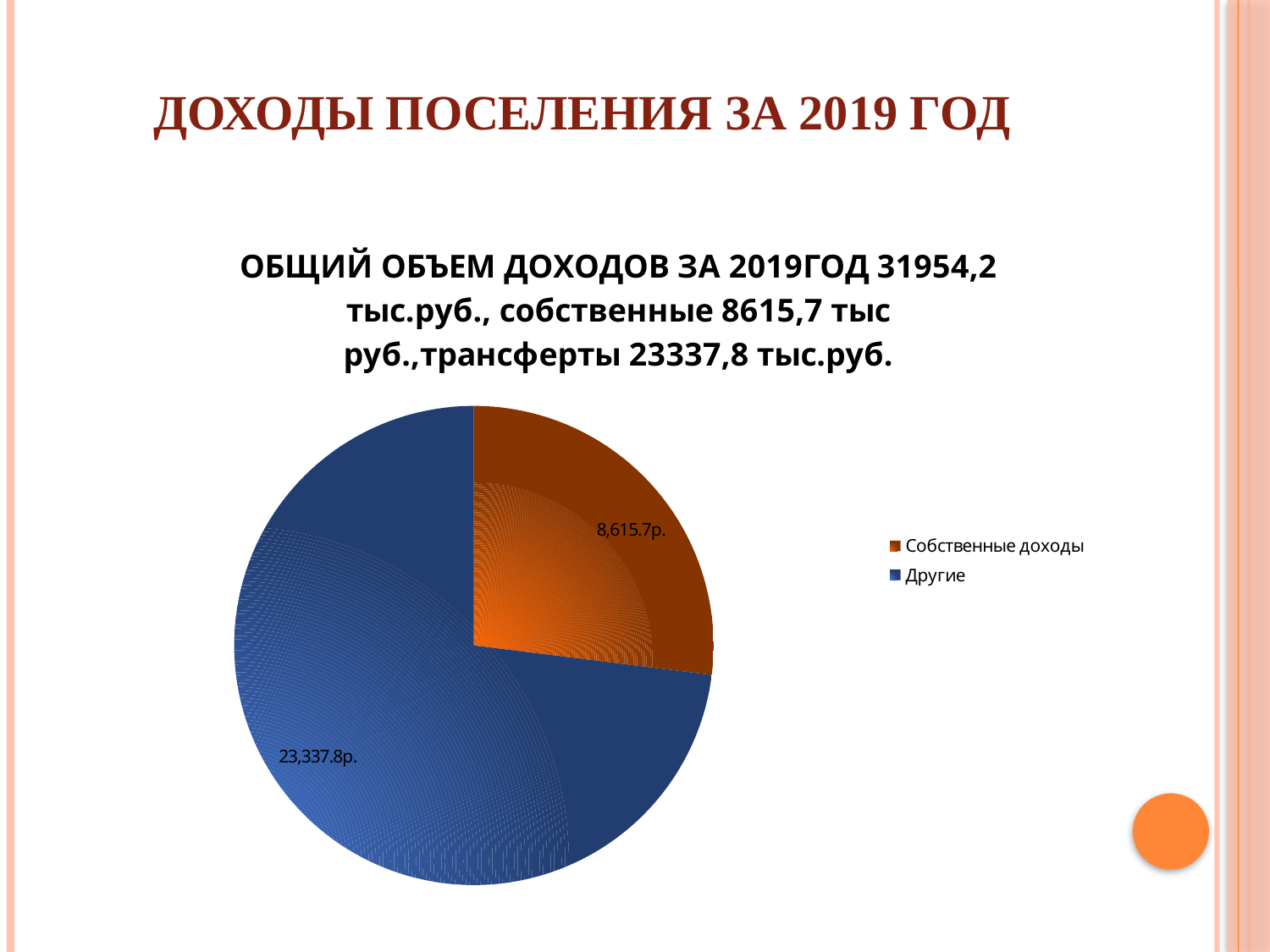
How many entries does the legend of the chart list? 2 What colour is the Собственные доходы slice in the pie chart? Orange Which slice of the pie chart is the smallest? Собственные доходы Which is larger in the pie chart, Собственные доходы or Другие? Другие Which slice of the pie chart is the largest? Другие What value is shown for the Другие slice of the pie chart? 23,337.8р. What is the total of the two values labelled on the pie chart? 31,953.5р. What type of chart is shown on the slide? Pie chart What is the title of the slide containing the pie chart? ДОХОДЫ ПОСЕЛЕНИЯ ЗА 2019 ГОД What is the difference between the Другие and Собственные доходы values in the pie chart? 14,722.1р. What value is shown for the Собственные доходы slice of the pie chart? 8,615.7р. How many slices does the pie chart have? 2